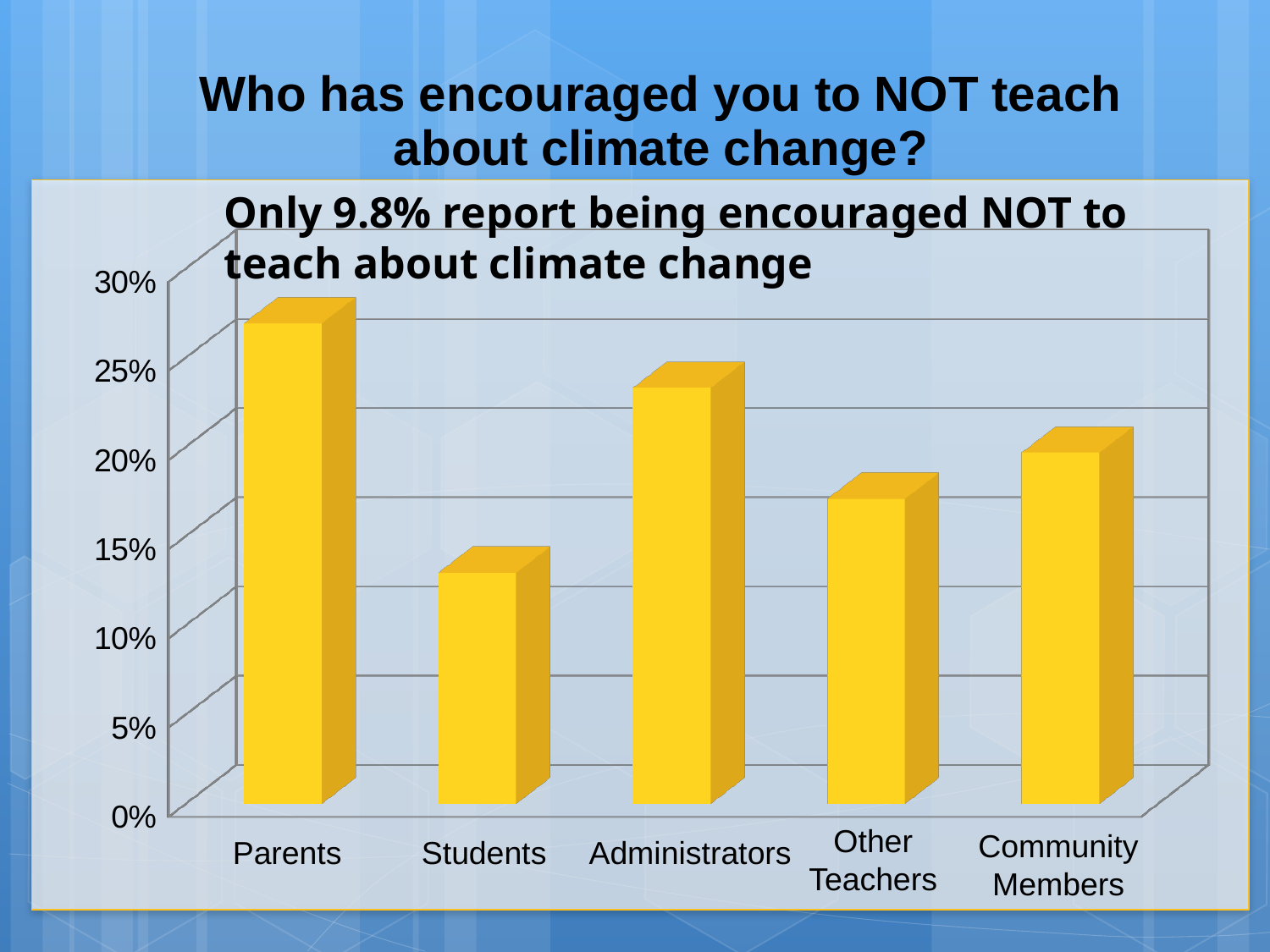
Is the value for Parents greater or less than 25%? greater What kind of chart is shown on the slide? bar chart Is the value for Administrators greater or less than 20%? greater Which is larger, the value for Administrators or the value for Other Teachers? Administrators Which is larger, the value for Students or the value for Community Members? Community Members Is the value for Other Teachers greater or less than 20%? less How many categories are shown on the x axis of the chart? 5 Which category has the highest bar in the chart? Parents Which category has the lowest bar in the chart? Students What percentage of respondents does the chart title say report being encouraged NOT to teach about climate change? 9.8%